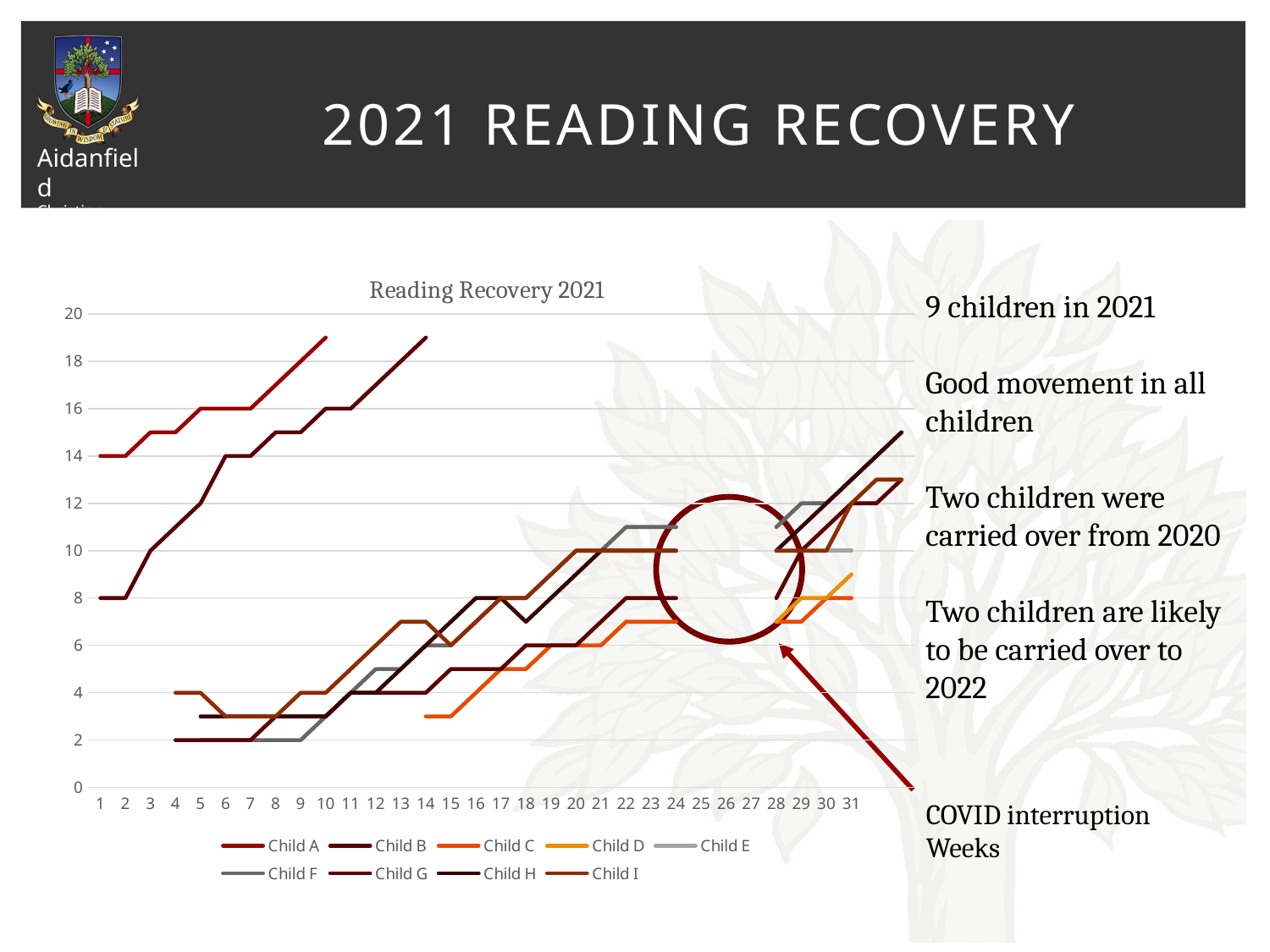
How many series does the chart's legend list? 9 How many weeks are shown along the x axis of the chart? 31 Is the value for Child B at week 1 greater or less than 10? less At week 1, which is larger, the value for Child A or the value for Child B? Child A What is the highest value shown on the chart's y axis? 20 What kind of chart is shown on the slide? line chart Is the value for Child A at week 10 greater or less than 18? greater What is the value for Child A at week 1? 14 What is the title of the chart? Reading Recovery 2021 Is the value for Child A at week 5 greater or less than 14? greater Do the lines on the chart generally rise or fall as the weeks increase? rise What is the value for Child B at week 1? 8